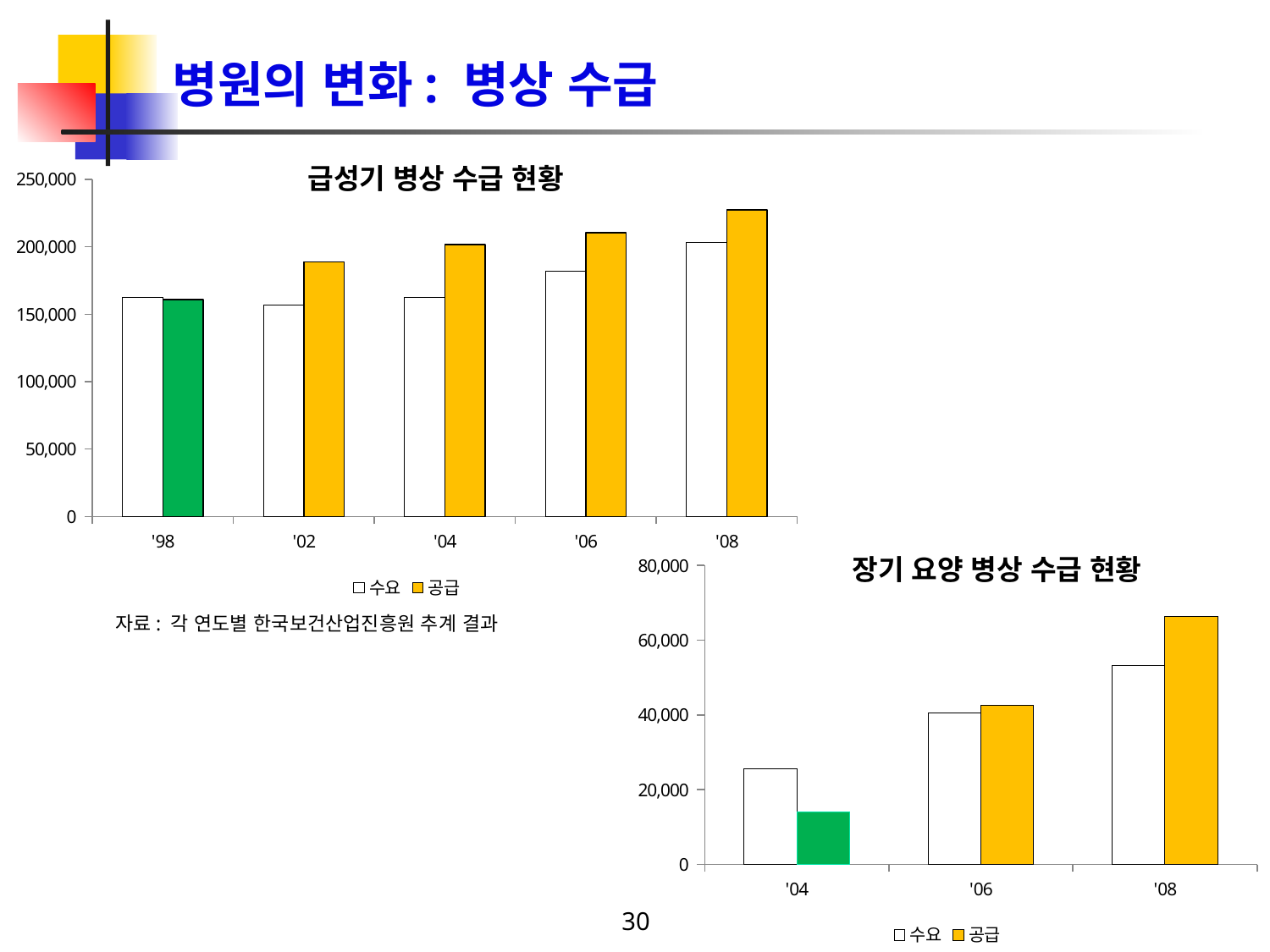
In the '급성기 병상 수급 현황' chart, how many years are shown on the x axis? 5 In the '장기 요양 병상 수급 현황' chart, which year has the lowest 수요 value? '04 In the '장기 요양 병상 수급 현황' chart, how many years are shown on the x axis? 3 In the '급성기 병상 수급 현황' chart, is the 수요 value for '06 greater or less than 200,000? less In the '장기 요양 병상 수급 현황' chart, which is larger for '04, 수요 or 공급? 수요 In the '장기 요양 병상 수급 현황' chart, is the 공급 value for '08 greater or less than 60,000? greater What kind of chart is the '급성기 병상 수급 현황' chart? bar chart In the '급성기 병상 수급 현황' chart, how many series does the legend list? 2 In the '급성기 병상 수급 현황' chart, is the 공급 value for '02 greater or less than 150,000? greater In the '급성기 병상 수급 현황' chart, which year has the highest 공급 value? '08 In the '급성기 병상 수급 현황' chart, which is larger for '04, 수요 or 공급? 공급 In the '급성기 병상 수급 현황' chart, does the 공급 series rise or fall from '98 to '08? rise